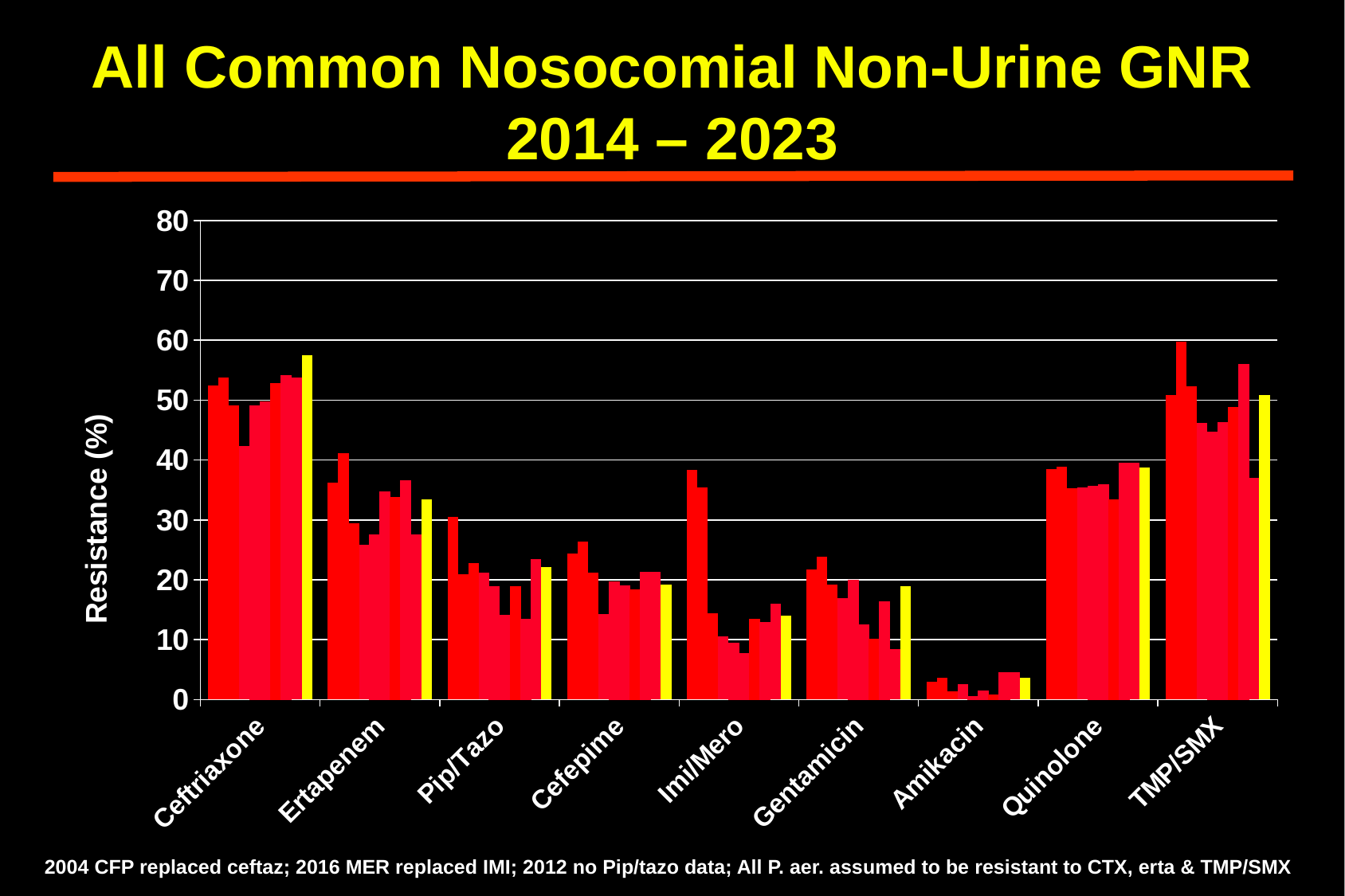
What is the label on the y axis? Resistance (%) Is the yellow (last) bar for Imi/Mero greater or less than 20? less Which antibiotic has the tallest single bar on the chart? TMP/SMX Which has higher resistance values, Quinolone or Amikacin? Quinolone Is the yellow (last) bar for Ceftriaxone greater or less than 50? greater What kind of chart is shown on the slide? bar chart How many bars are plotted for each antibiotic category? 10 Is the yellow (last) bar for Amikacin greater or less than 10? less What is the title of the chart? All Common Nosocomial Non-Urine GNR 2014 – 2023 Which antibiotic has the lowest resistance values overall? Amikacin How many antibiotic categories are shown on the x axis? 9